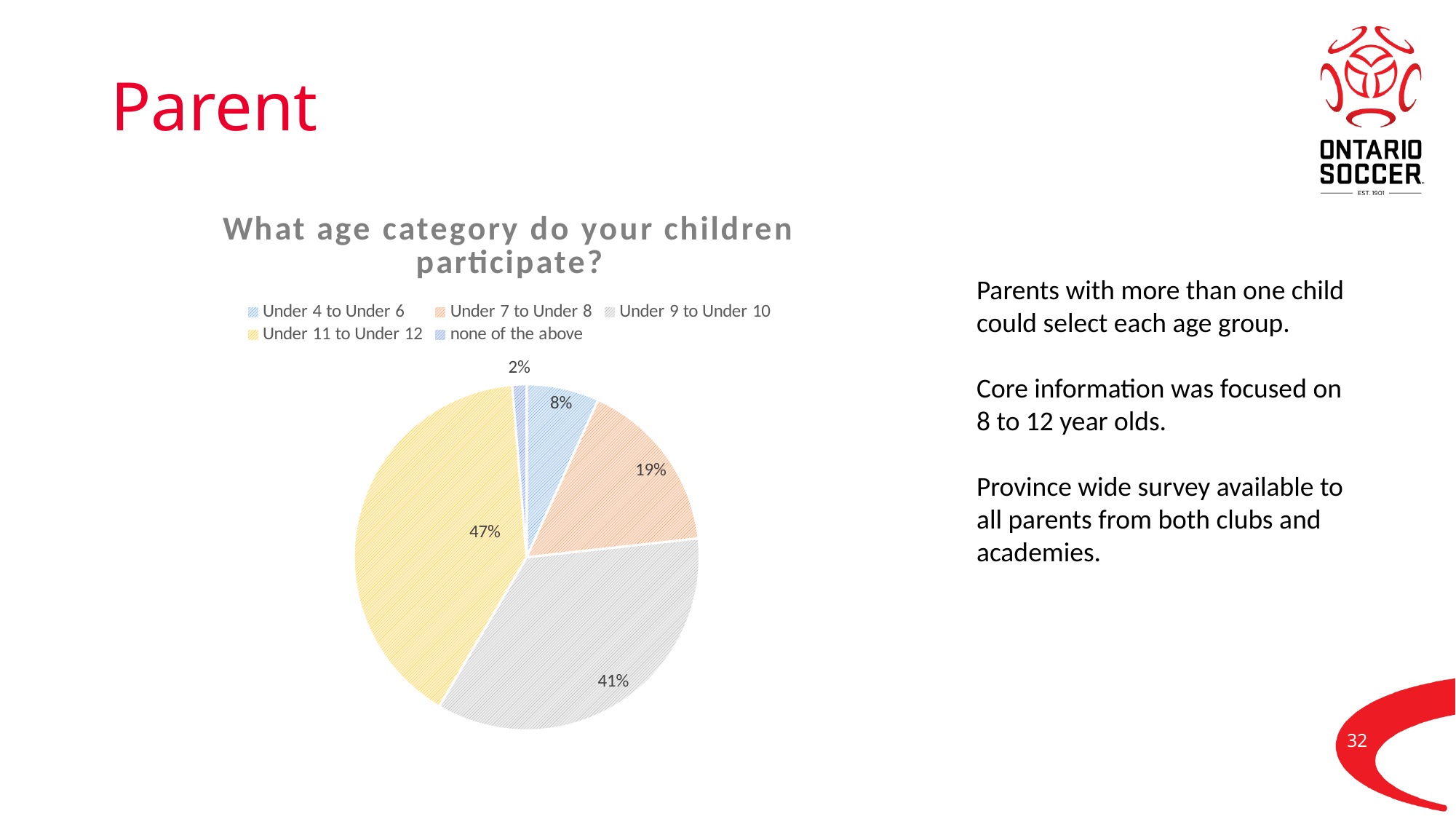
What percentage is shown for Under 11 to Under 12? 47% What percentage is shown for Under 7 to Under 8? 19% What is the difference in percentage points between Under 11 to Under 12 and Under 9 to Under 10? 6 What percentage is shown for Under 4 to Under 6? 8% Which category has the smallest slice of the pie? none of the above What percentage is shown for Under 9 to Under 10? 41% Which age category has the largest slice of the pie? Under 11 to Under 12 What is the title of the chart? What age category do your children participate? How many categories does the legend of the pie chart list? 5 What percentage is shown for 'none of the above'? 2% Which is larger, the slice for Under 7 to Under 8 or the slice for Under 4 to Under 6? Under 7 to Under 8 What type of chart is shown on the slide? Pie chart